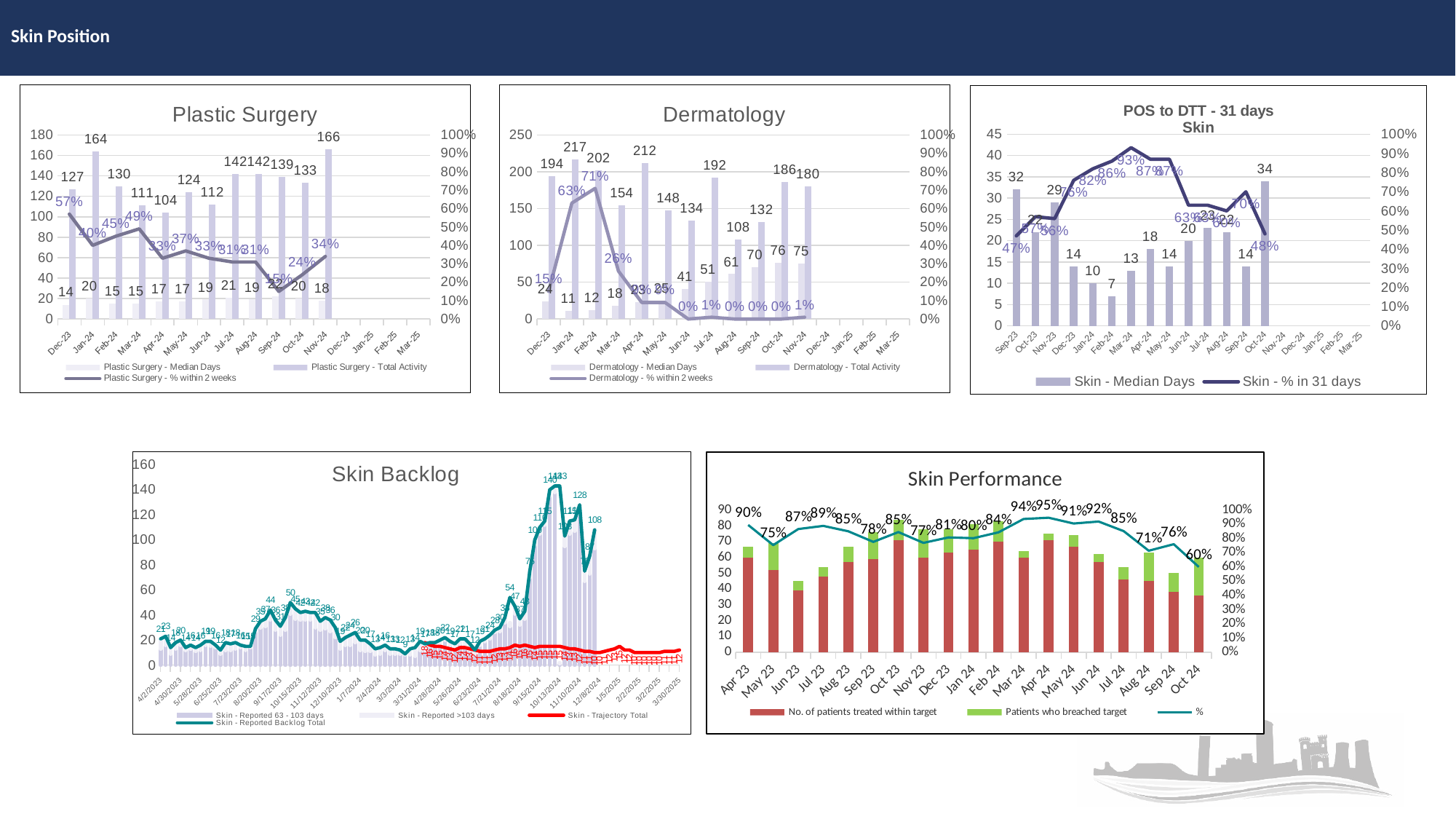
In the Dermatology chart, what was the Total Activity in Jan-24? 217 In the POS to DTT - 31 days Skin chart, what was the Median Days value in Oct-24? 34 In the Plastic Surgery chart, which month had the lowest Total Activity? Apr-24 In the Skin Performance chart, which month had the highest percentage? Apr 24 In the POS to DTT - 31 days Skin chart, what was the % in 31 days in Mar-24? 93% In the POS to DTT - 31 days Skin chart, which month had the lowest Median Days? Feb-24 In the Dermatology chart, what is the difference in Total Activity between Jan-24 and Aug-24? 109 In the Plastic Surgery chart, what was the % within 2 weeks in Dec-23? 57% In the Plastic Surgery chart, what was the Total Activity in Nov-24? 166 In the Dermatology chart, what was the Median Days value in Oct-24? 76 In the Skin Performance chart, what was the percentage for Oct 24? 60% How many series does the legend of the Skin Performance chart list? 3